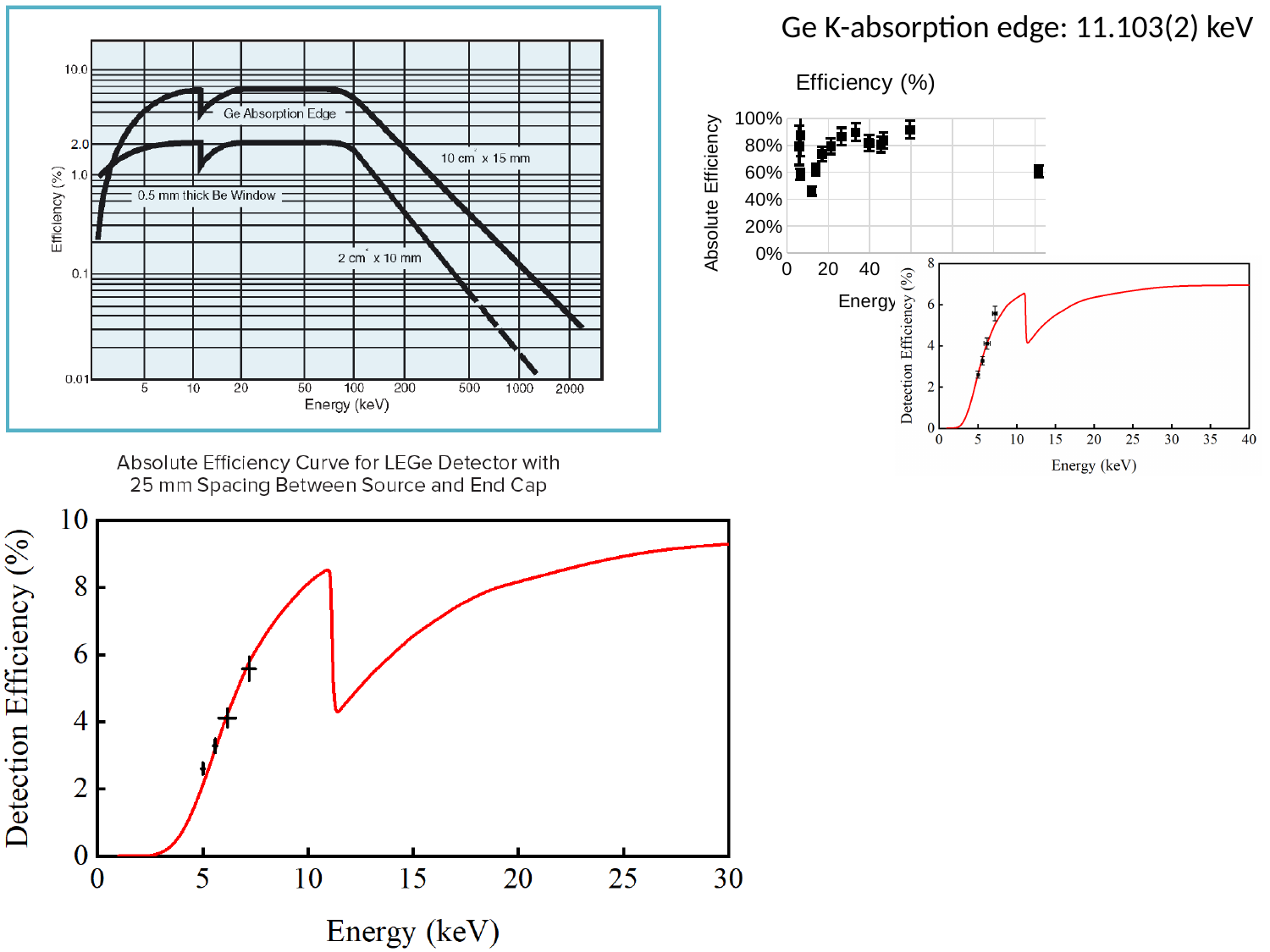
What kind of chart is the top-right chart titled 'Efficiency (%)' with Absolute Efficiency on the y-axis? scatter chart What kind of chart is the top-left chart titled 'Absolute Efficiency Curve for LEGe Detector with 25 mm Spacing Between Source and End Cap'? line chart In the top-left chart, what feature is labelled near 10 keV? Ge Absorption Edge In the bottom-left Detection Efficiency chart, is the detection efficiency at 30 keV greater or less than 8? greater In the top-left chart, which curve is higher at 50 keV, '10 cm² x 15 mm' or '2 cm² x 10 mm'? 10 cm² x 15 mm In the bottom-left Detection Efficiency chart, does the curve rise or fall between 15 keV and 30 keV? rise In the bottom-left Detection Efficiency chart, how many measured data points with error bars are plotted? 4 In the top-left chart, do the efficiency curves rise or fall as energy increases above 100 keV? fall In the top-right 'Efficiency (%)' scatter chart, is the lowest plotted absolute efficiency greater or less than 60%? less In the small right-hand Detection Efficiency chart with energy up to 40 keV, is the peak of the curve just before the edge greater or less than 6? greater In the top-right 'Efficiency (%)' scatter chart, what is the highest value shown on the y-axis? 100%